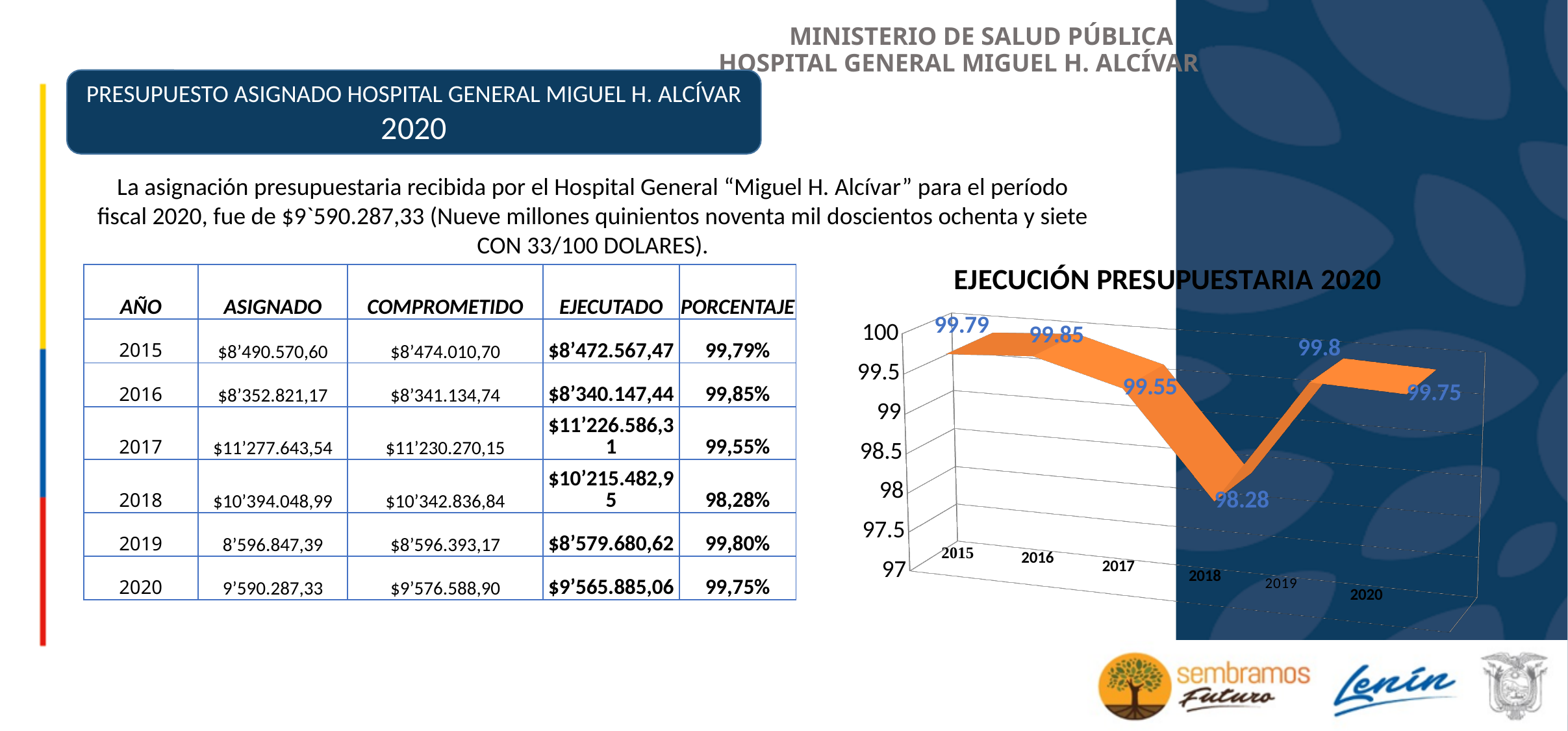
In the chart EJECUCIÓN PRESUPUESTARIA 2020, what is the difference between the values for 2016 and 2018? 1.57 In the chart EJECUCIÓN PRESUPUESTARIA 2020, which year has the highest value? 2016 In the chart EJECUCIÓN PRESUPUESTARIA 2020, what is the value for 2016? 99.85 What kind of chart is EJECUCIÓN PRESUPUESTARIA 2020? 3D line chart In the chart EJECUCIÓN PRESUPUESTARIA 2020, what is the value for 2018? 98.28 In the chart EJECUCIÓN PRESUPUESTARIA 2020, is the value for 2018 greater or less than 98.5? less How many years are plotted in the chart EJECUCIÓN PRESUPUESTARIA 2020? 6 In the chart EJECUCIÓN PRESUPUESTARIA 2020, does the value rise or fall from 2017 to 2018? fall What is the title of the chart on the right side of the slide? EJECUCIÓN PRESUPUESTARIA 2020 In the chart EJECUCIÓN PRESUPUESTARIA 2020, which is larger, the value for 2017 or the value for 2019? 2019 In the chart EJECUCIÓN PRESUPUESTARIA 2020, what is the value for 2020? 99.75 In the chart EJECUCIÓN PRESUPUESTARIA 2020, which year has the lowest value? 2018